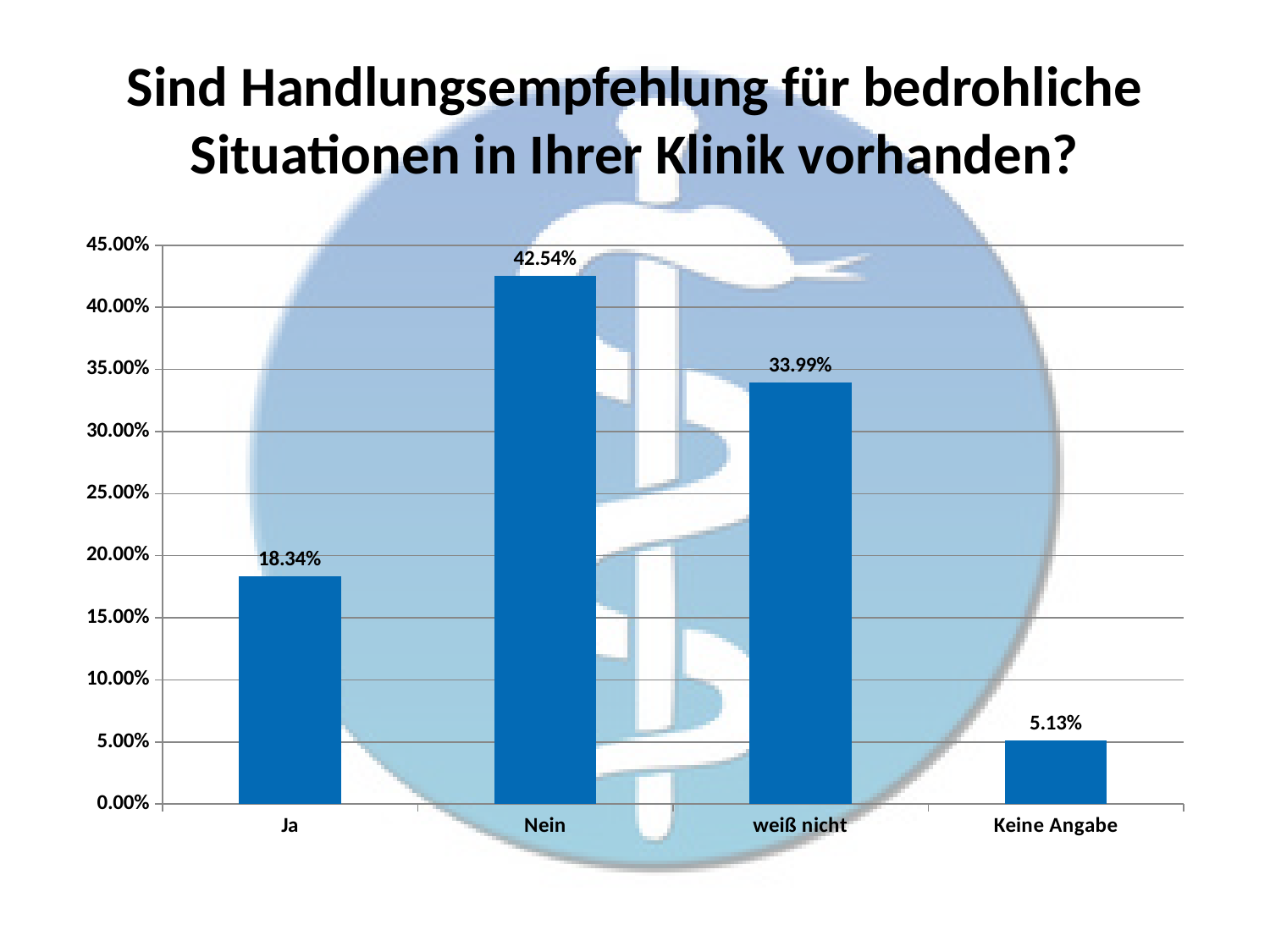
Which category has the lowest value? Keine Angabe What kind of chart is shown on the slide? bar chart What is the difference between the values for "Nein" and "weiß nicht"? 8.55% How many categories are shown on the x axis? 4 Is the value for "Ja" greater or less than 20.00%? less Which category has the highest value? Nein What is the title of the chart? Sind Handlungsempfehlung für bedrohliche Situationen in Ihrer Klinik vorhanden? What is the value for "Keine Angabe"? 5.13% Which is larger, the value for "Ja" or the value for "weiß nicht"? weiß nicht What is the value for "Ja"? 18.34% What is the value for "weiß nicht"? 33.99% What is the value for "Nein"? 42.54%